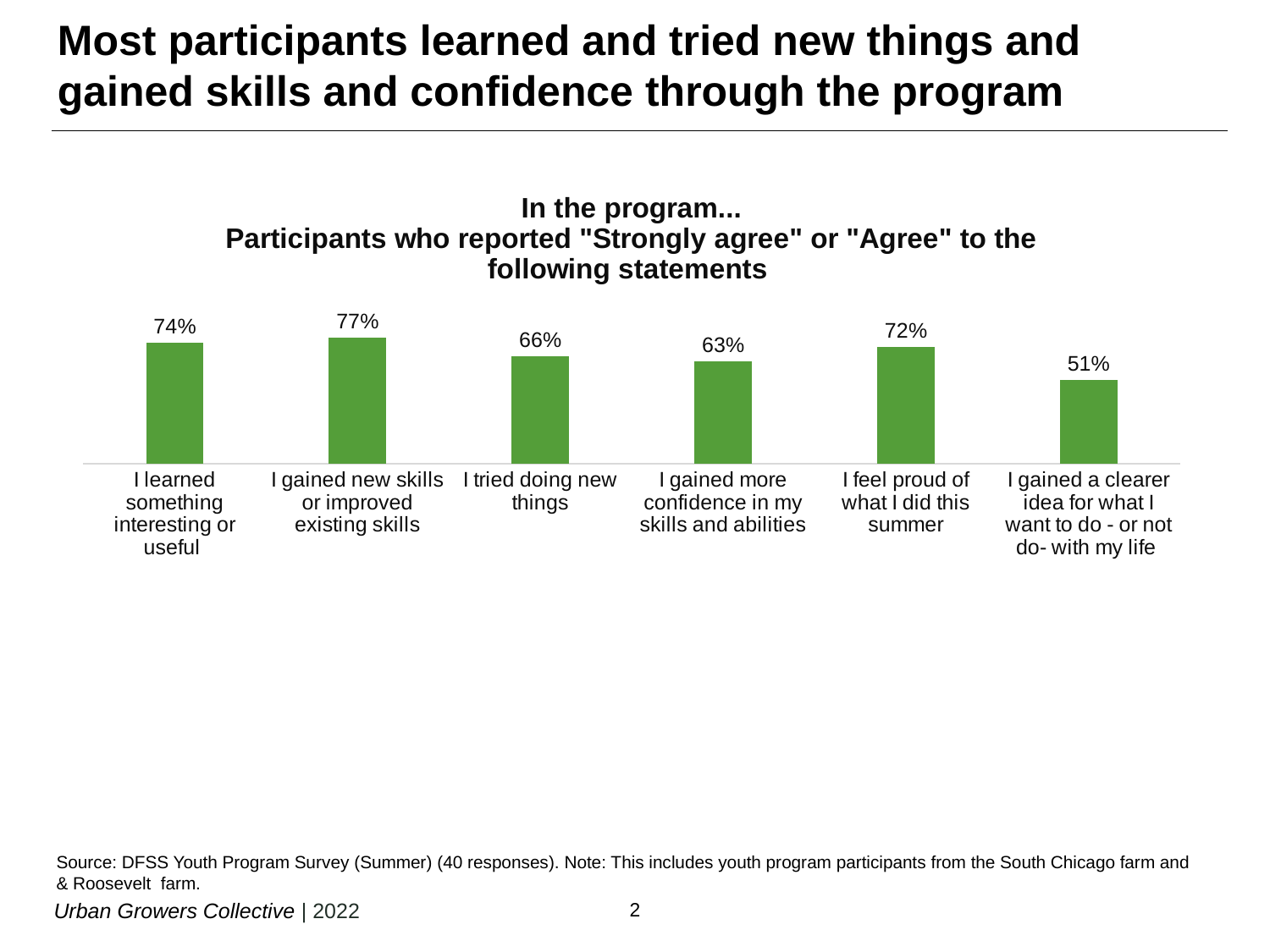
What colour are the bars in the chart? Green Which statement had the highest share of participants reporting "Strongly agree" or "Agree"? I gained new skills or improved existing skills What percentage of participants agreed with "I gained a clearer idea for what I want to do - or not do- with my life"? 51% How many statements are shown in the chart? 6 What is the difference in percentage points between "I gained new skills or improved existing skills" and "I gained a clearer idea for what I want to do - or not do- with my life"? 26 percentage points What is the difference in percentage points between "I tried doing new things" and "I gained more confidence in my skills and abilities"? 3 percentage points What percentage of participants agreed with "I learned something interesting or useful"? 74% Which statement had the lowest share of participants reporting "Strongly agree" or "Agree"? I gained a clearer idea for what I want to do - or not do- with my life What type of chart is shown on the slide? Bar chart Which had a higher share of agreement: "I learned something interesting or useful" or "I tried doing new things"? I learned something interesting or useful What percentage of participants agreed with "I feel proud of what I did this summer"? 72% How many survey responses does the source note say the chart is based on? 40 responses